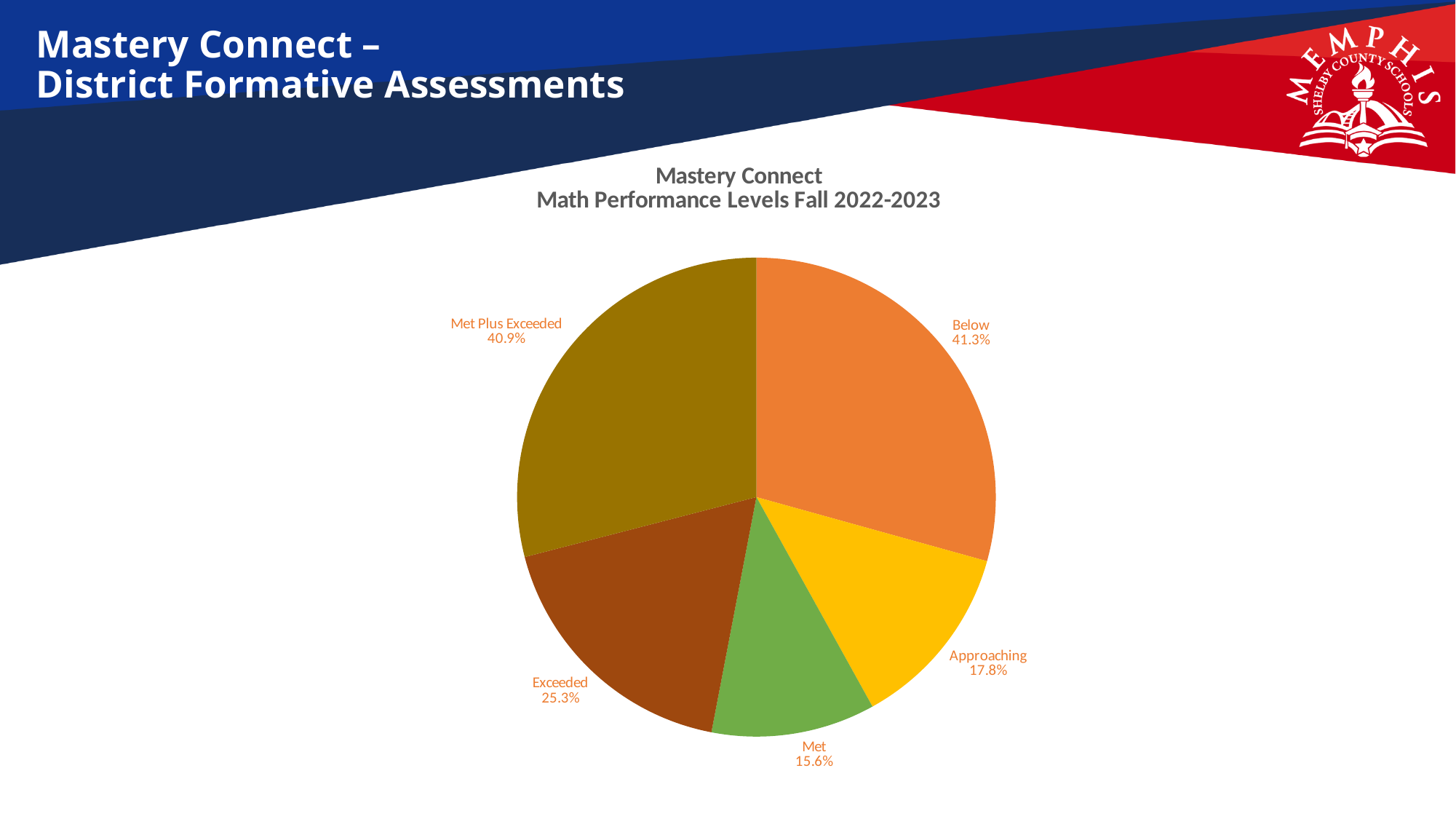
What is the difference in percentage points between the Below slice and the Met slice? 25.7 What percentage is shown for the Met Plus Exceeded slice? 40.9% Which slice has the smallest percentage? Met Which is larger, the Exceeded slice or the Approaching slice? Exceeded What type of chart is shown on the slide? pie chart What percentage is shown for the Met slice? 15.6% What percentage is shown for the Approaching slice? 17.8% What is the title of the chart? Mastery Connect Math Performance Levels Fall 2022-2023 What colour is the Met slice? green How many slices does the pie chart have? 5 What percentage is shown for the Below slice? 41.3% What percentage is shown for the Exceeded slice? 25.3%